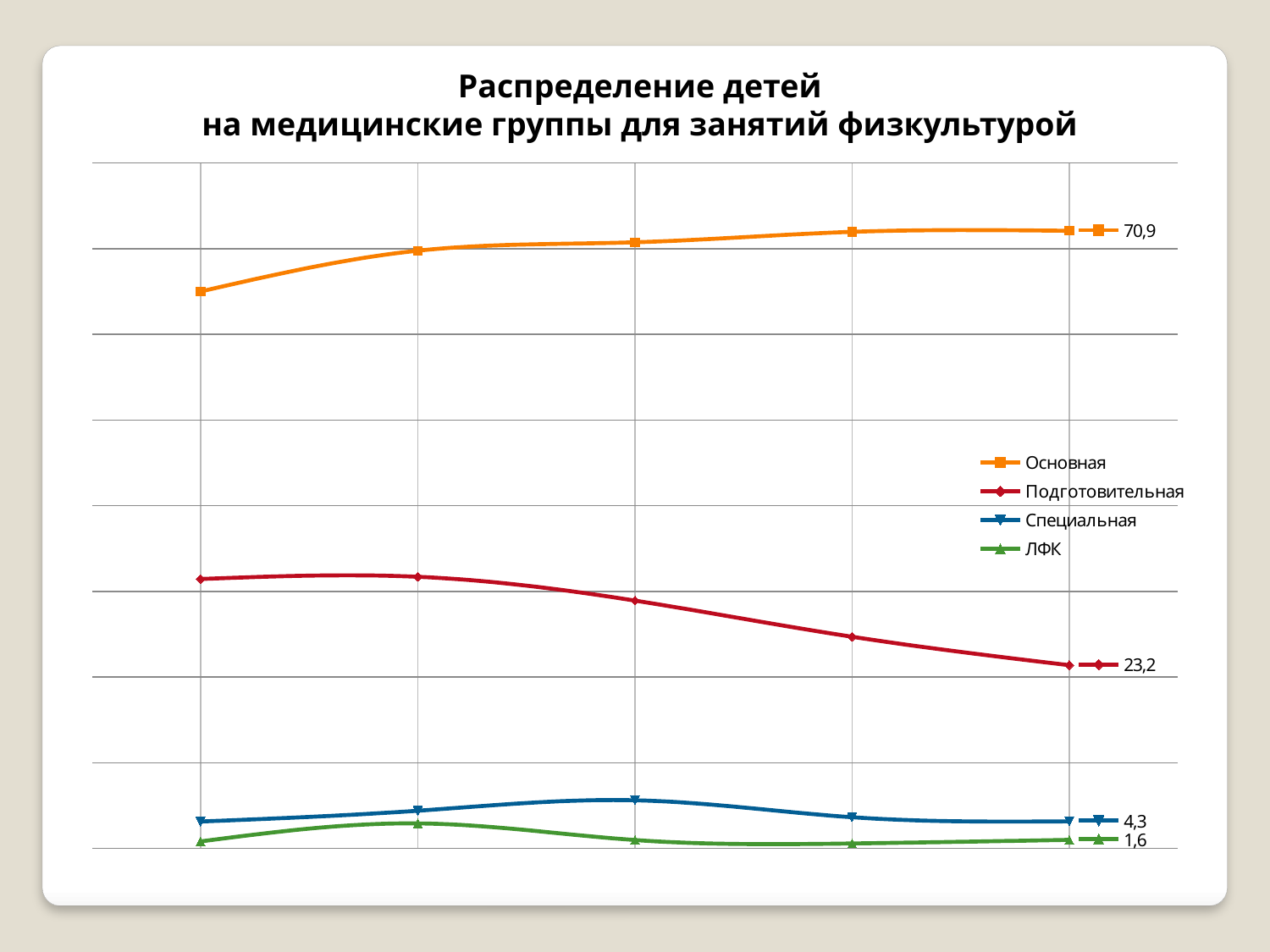
What is the value labelled at the last point of the Специальная line? 4,3 What is the difference between the last labelled values of Основная and Подготовительная? 47,7 Does the Подготовительная line rise or fall from left to right? Falls How many series does the legend list? 4 What kind of chart is shown on the slide? Line chart What is the value labelled at the last point of the Основная line? 70,9 How many data points does each line have? 5 Which series has the highest values across the chart? Основная What is the value labelled at the last point of the Подготовительная line? 23,2 Which series has the lowest value at the last point? ЛФК What is the value labelled at the last point of the ЛФК line? 1,6 What is the title of the chart? Распределение детей на медицинские группы для занятий физкультурой